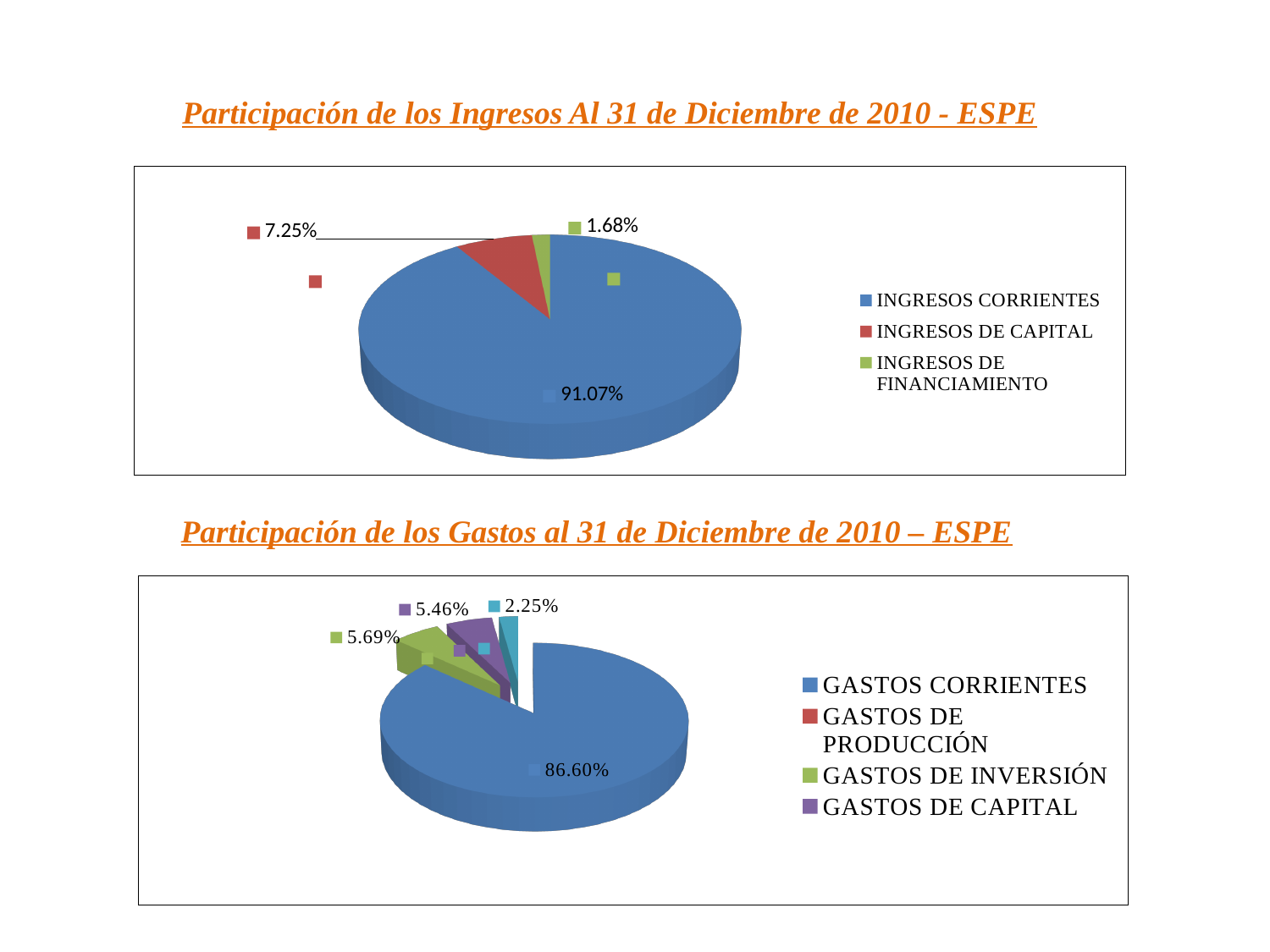
In the top chart (Participación de los Ingresos), how many entries does the legend list? 3 In the bottom chart (Participación de los Gastos), what share does GASTOS CORRIENTES have? 86.60% In the bottom chart (Participación de los Gastos), what is the value for GASTOS DE INVERSIÓN? 5.69% In the top chart (Participación de los Ingresos), which category has the smallest share? INGRESOS DE FINANCIAMIENTO In the top chart (Participación de los Ingresos), what share does INGRESOS CORRIENTES have? 91.07% What type of chart is the bottom chart (Participación de los Gastos)? Pie chart In the bottom chart (Participación de los Gastos), what is the value for GASTOS DE CAPITAL? 5.46% In the top chart (Participación de los Ingresos), what is the value for INGRESOS DE CAPITAL? 7.25% In the top chart (Participación de los Ingresos), what is the difference between INGRESOS DE CAPITAL and INGRESOS DE FINANCIAMIENTO? 5.57% In the top chart (Participación de los Ingresos), what is the value for INGRESOS DE FINANCIAMIENTO? 1.68% In the bottom chart (Participación de los Gastos), how many entries does the legend list? 4 In the bottom chart (Participación de los Gastos), which category has the largest share? GASTOS CORRIENTES